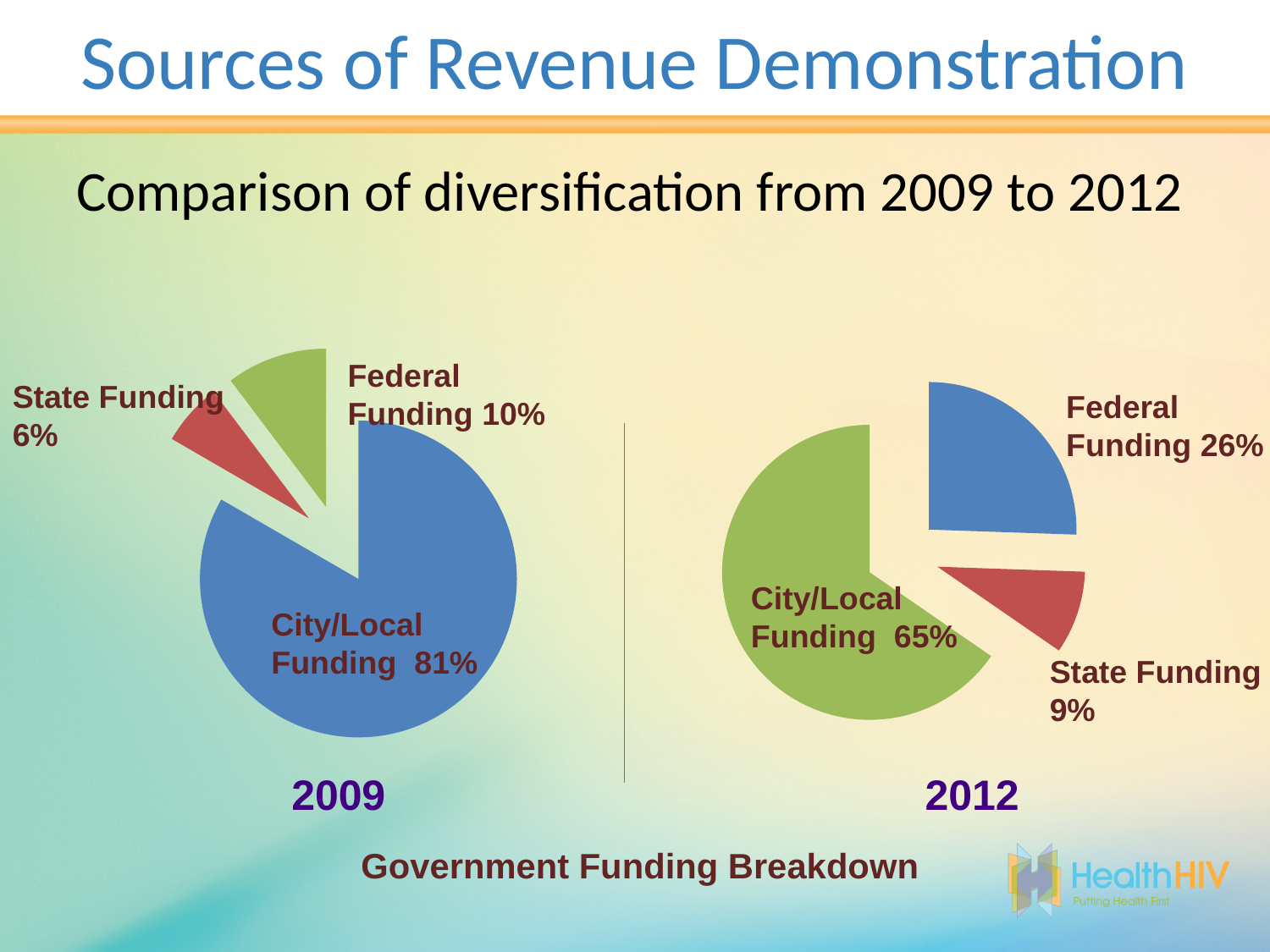
In the 2012 pie chart, which is larger: Federal Funding or State Funding? Federal Funding What is the difference in percentage points between Federal Funding in 2012 and Federal Funding in 2009? 16 In the 2009 pie chart, what share is State Funding? 6% In the 2012 pie chart, what share is City/Local Funding? 65% In the 2012 pie chart, what share is Federal Funding? 26% In the 2012 pie chart, what share is State Funding? 9% How many slices does the 2009 pie chart have? 3 What type of chart is used to show the 2012 Government Funding Breakdown? Pie chart In the 2009 pie chart, which funding source has the smallest share? State Funding In the 2012 pie chart, which funding source has the largest share? City/Local Funding In the 2009 pie chart, what share is City/Local Funding? 81% In the 2009 pie chart, what share is Federal Funding? 10%